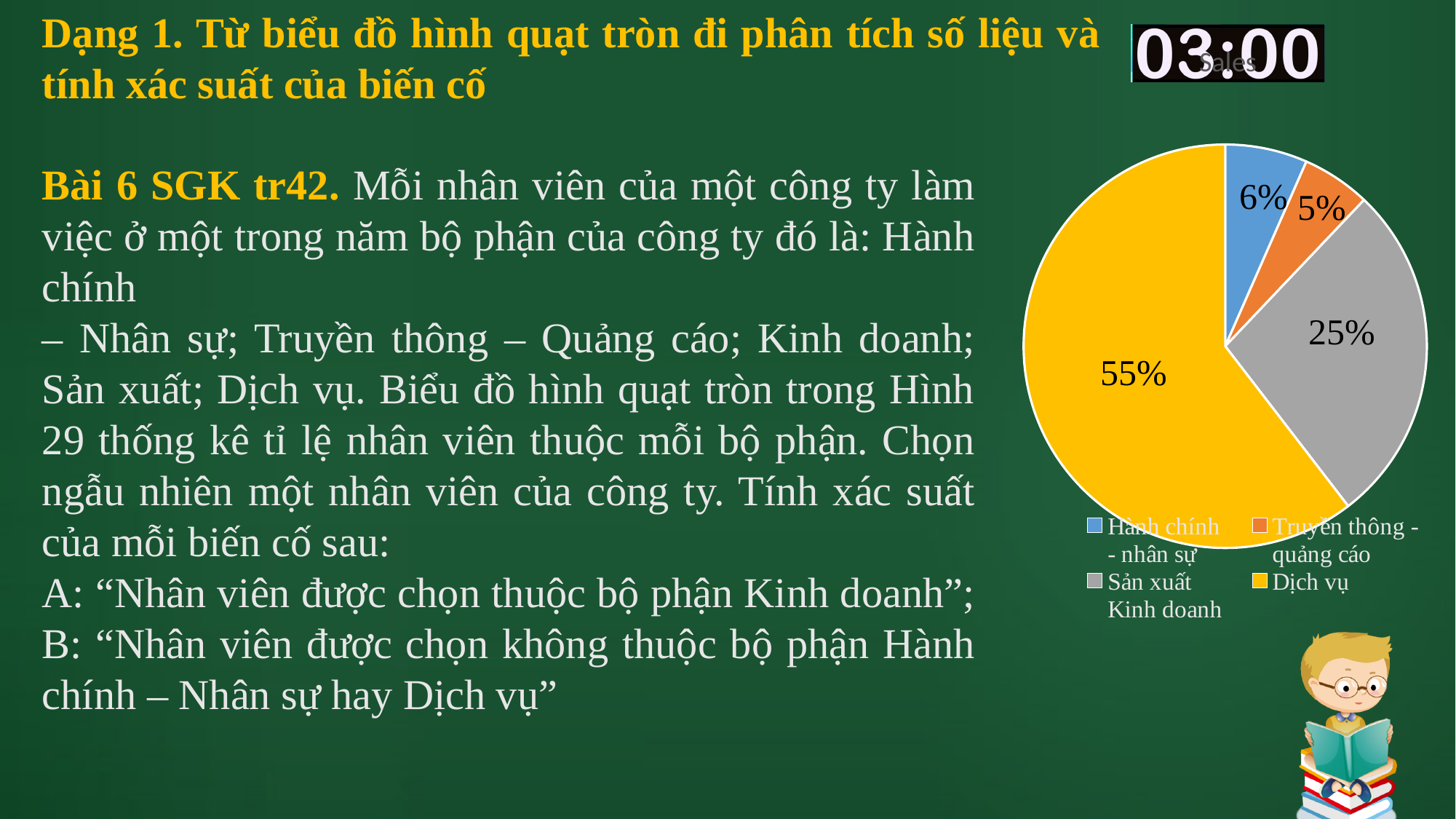
Which is larger, the Hành chính - nhân sự slice or the Truyền thông - quảng cáo slice? Hành chính - nhân sự What kind of chart is shown on the slide? pie chart How many slices does the pie chart have? 4 What colour is the Dịch vụ slice? yellow How many entries does the legend list? 4 What percentage does the Dịch vụ slice show? 55% What percentage does the Truyền thông - quảng cáo slice show? 5% What is the difference in percentage points between the Dịch vụ slice and the Sản xuất Kinh doanh slice? 30 What percentage does the Sản xuất Kinh doanh slice show? 25% Which slice of the pie chart is the largest? Dịch vụ Which slice of the pie chart is the smallest? Truyền thông - quảng cáo What percentage does the Hành chính - nhân sự slice show? 6%